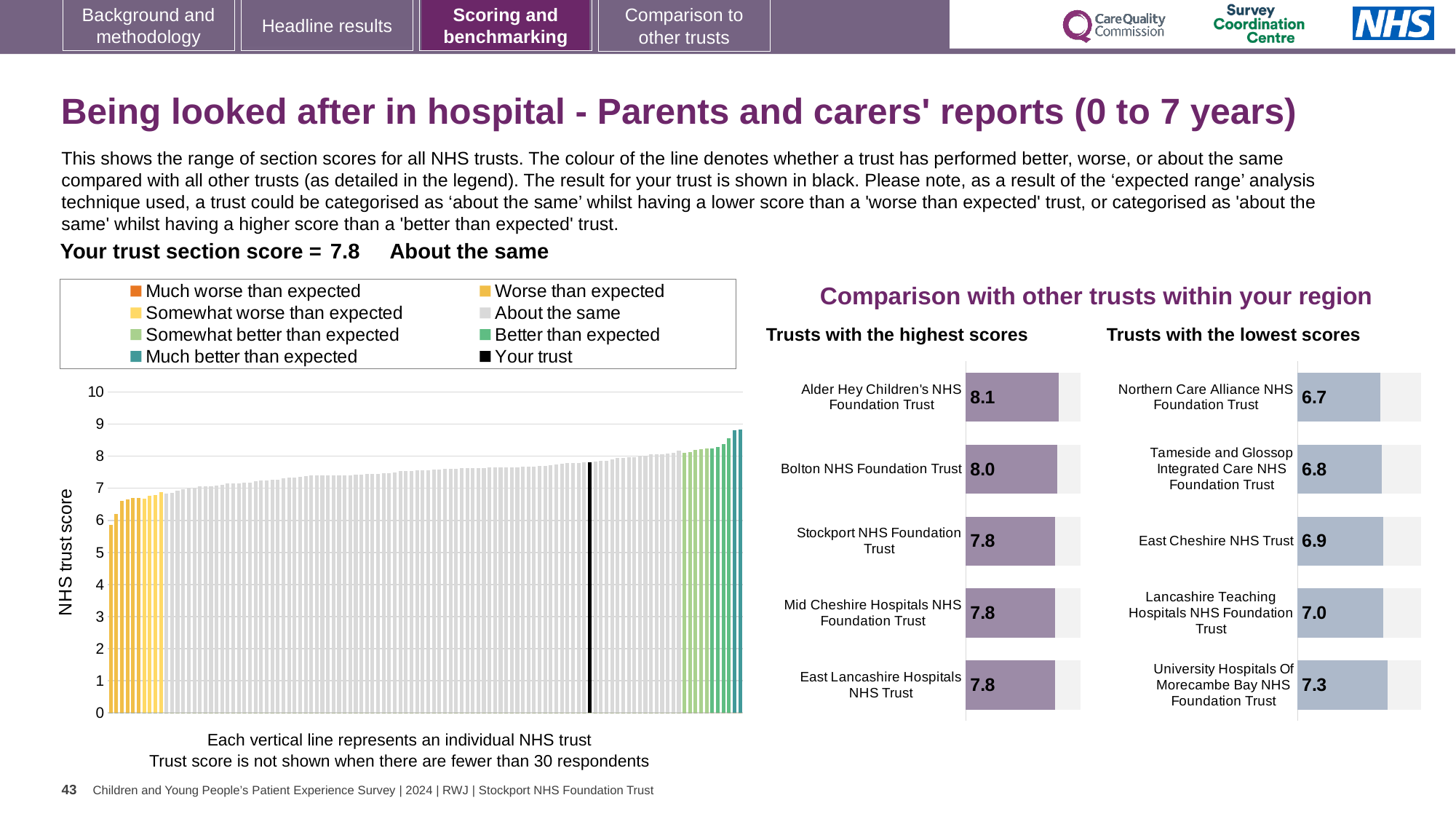
In the 'Trusts with the lowest scores' chart, which trust has the lowest score? Northern Care Alliance NHS Foundation Trust What is the difference between the score for Alder Hey Children's NHS Foundation Trust in the highest scores chart and the score for Northern Care Alliance NHS Foundation Trust in the lowest scores chart? 1.4 How many trusts are shown in the 'Trusts with the highest scores' chart? 5 In the 'Trusts with the highest scores' chart, what is the score for Alder Hey Children's NHS Foundation Trust? 8.1 How many entries does the legend of the main 'NHS trust score' chart list? 8 In the 'Trusts with the highest scores' chart, which trust has the highest score? Alder Hey Children's NHS Foundation Trust In the main 'NHS trust score' chart on the left, is the value of the tallest bar greater or less than 8? greater In the 'Trusts with the lowest scores' chart, which has the larger score: University Hospitals Of Morecambe Bay NHS Foundation Trust or Tameside and Glossop Integrated Care NHS Foundation Trust? University Hospitals Of Morecambe Bay NHS Foundation Trust In the main 'NHS trust score' chart on the left, do the values rise or fall from left to right? rise In the 'Trusts with the lowest scores' chart, what is the score for East Cheshire NHS Trust? 6.9 What kind of chart is the 'Trusts with the lowest scores' chart? bar chart In the main 'NHS trust score' chart on the left, what is the section score for your trust (the black line)? 7.8